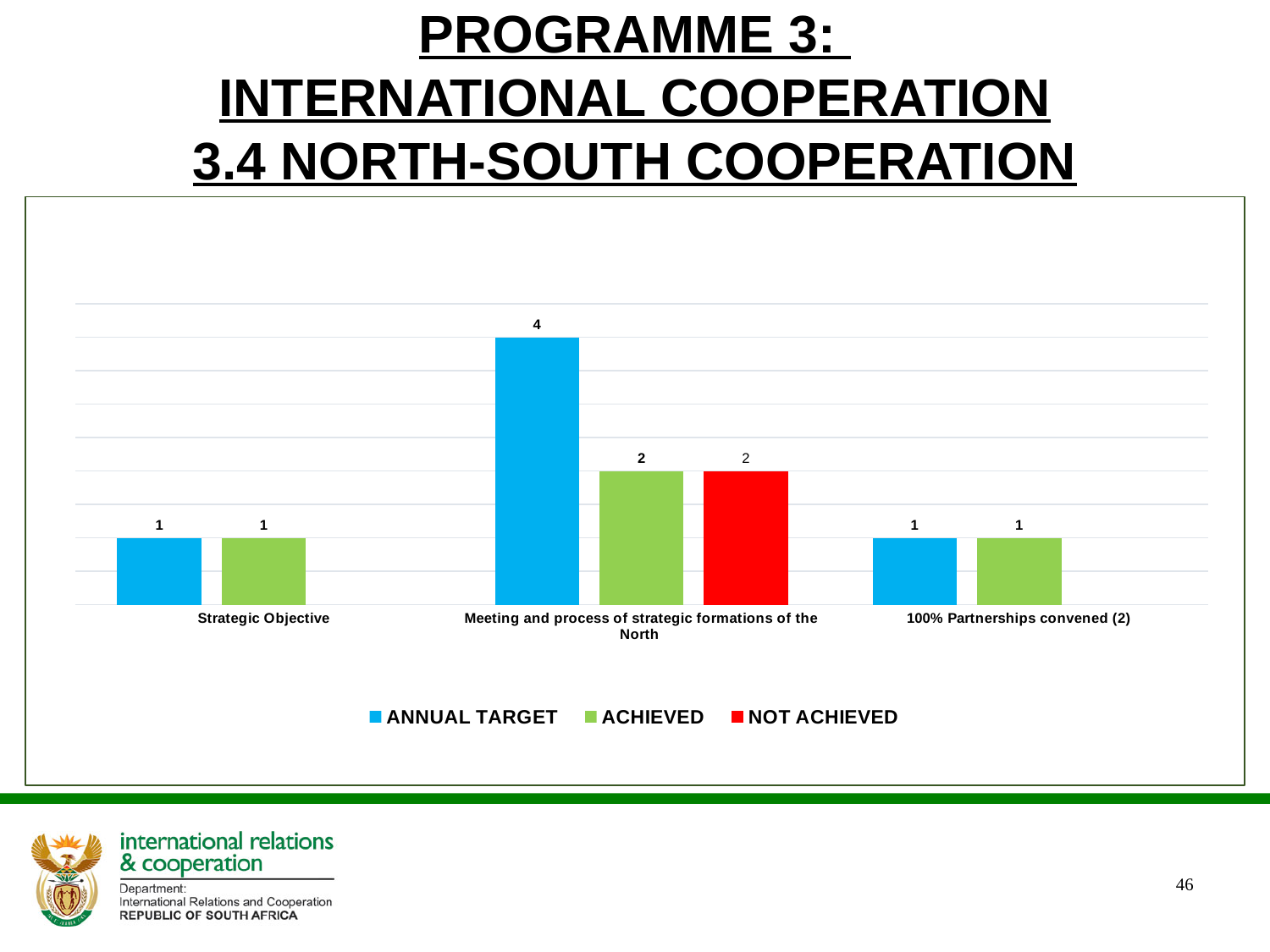
What is the ACHIEVED value for "Meeting and process of strategic formations of the North"? 2 Which is larger: the ANNUAL TARGET for "Meeting and process of strategic formations of the North" or the ANNUAL TARGET for "Strategic Objective"? Meeting and process of strategic formations of the North Which category has the highest ANNUAL TARGET value? Meeting and process of strategic formations of the North What is the ANNUAL TARGET value for "100% Partnerships convened (2)"? 1 How many series does the legend list? 3 What is the NOT ACHIEVED value for "Meeting and process of strategic formations of the North"? 2 What is the ACHIEVED value for "Strategic Objective"? 1 What kind of chart is shown on the slide? Bar chart What is the ANNUAL TARGET value for "Meeting and process of strategic formations of the North"? 4 How many categories are shown on the x axis? 3 Which series is shown in red in the legend? NOT ACHIEVED What is the difference between the ANNUAL TARGET and ACHIEVED values for "Meeting and process of strategic formations of the North"? 2